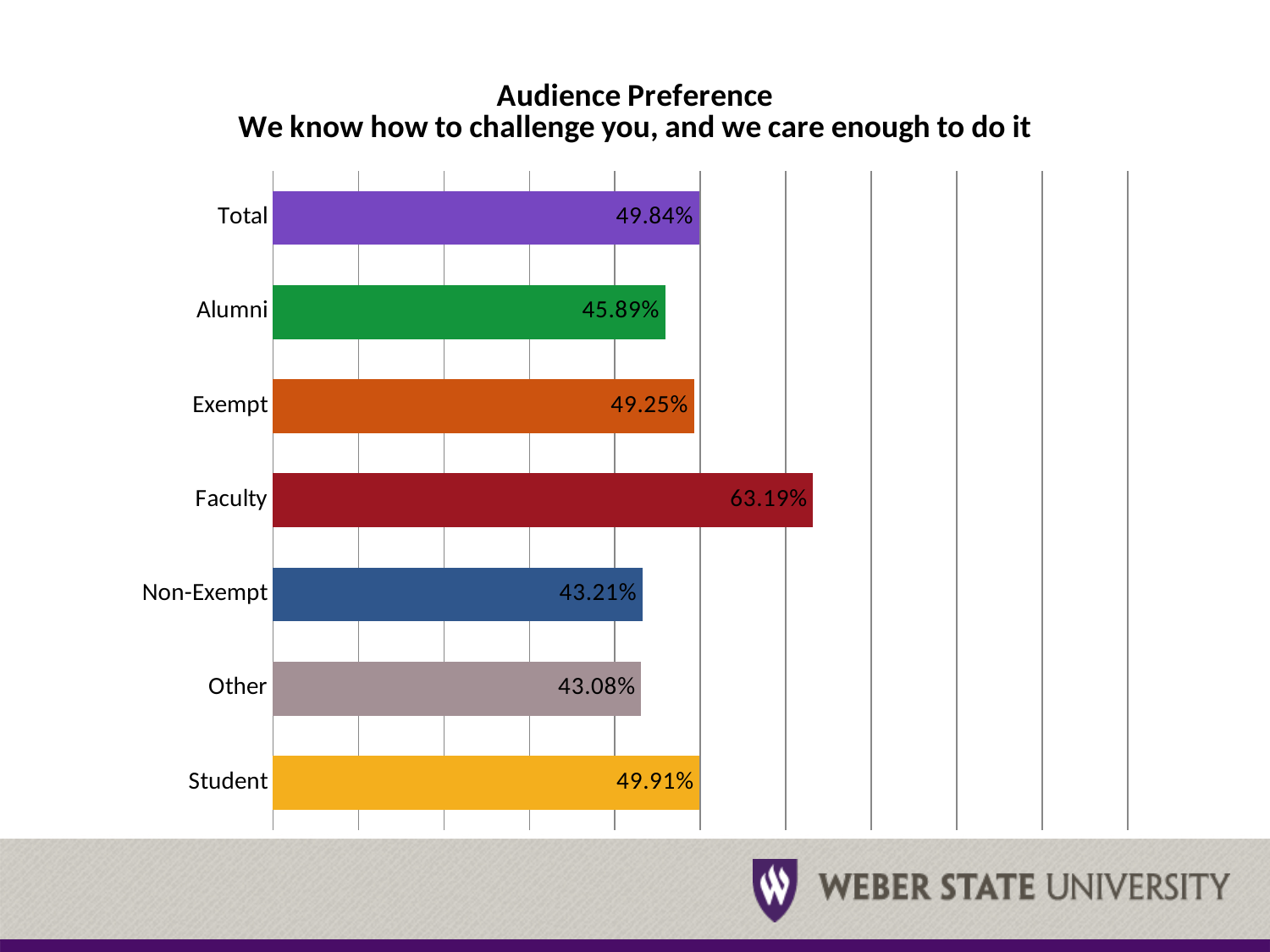
Which is larger, the value for Exempt or the value for Alumni? Exempt What is the value for Total? 49.84% What is the title of the chart? Audience Preference We know how to challenge you, and we care enough to do it What is the value for Alumni? 45.89% Which category has the lowest value? Other How many categories are shown in the chart? 7 Which category has the highest value? Faculty What is the difference between the Exempt value and the Alumni value? 3.36% What is the value for Faculty? 63.19% What kind of chart is shown on the slide? Bar chart What is the value for Non-Exempt? 43.21% What is the difference between the Faculty value and the Student value? 13.28%